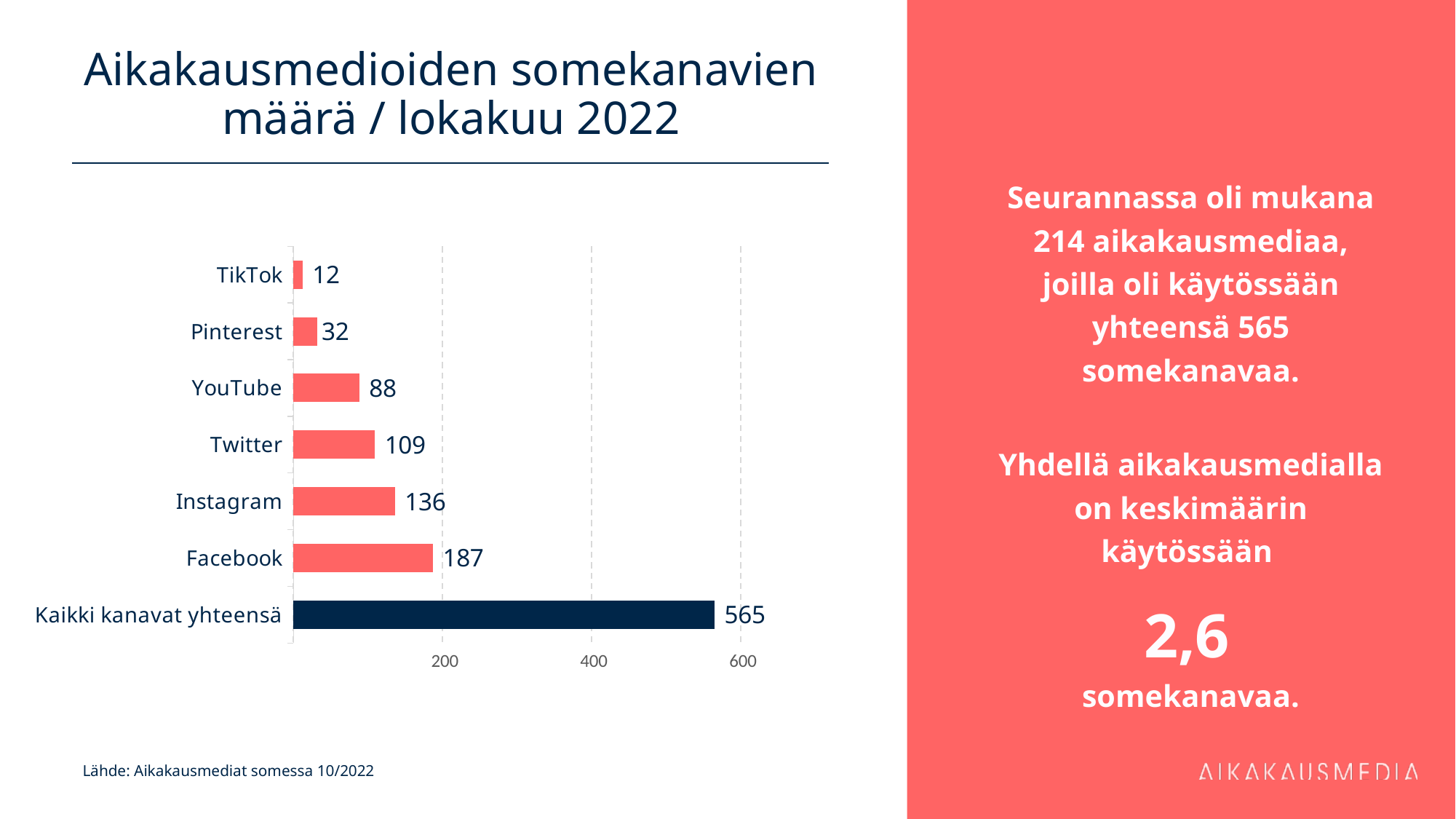
What kind of chart is shown on the slide? bar chart What is the difference between the values for Facebook and Instagram? 51 Which individual social media channel has the highest value? Facebook Which category has the lowest value? TikTok What is the value for Kaikki kanavat yhteensä? 565 What is the title of the chart? Aikakausmedioiden somekanavien määrä / lokakuu 2022 Which has a larger value, Twitter or YouTube? Twitter Is the value for Facebook greater or less than 200? less What is the value for TikTok? 12 What is the value for Facebook? 187 What is the value for Instagram? 136 How many categories are shown in the chart? 7